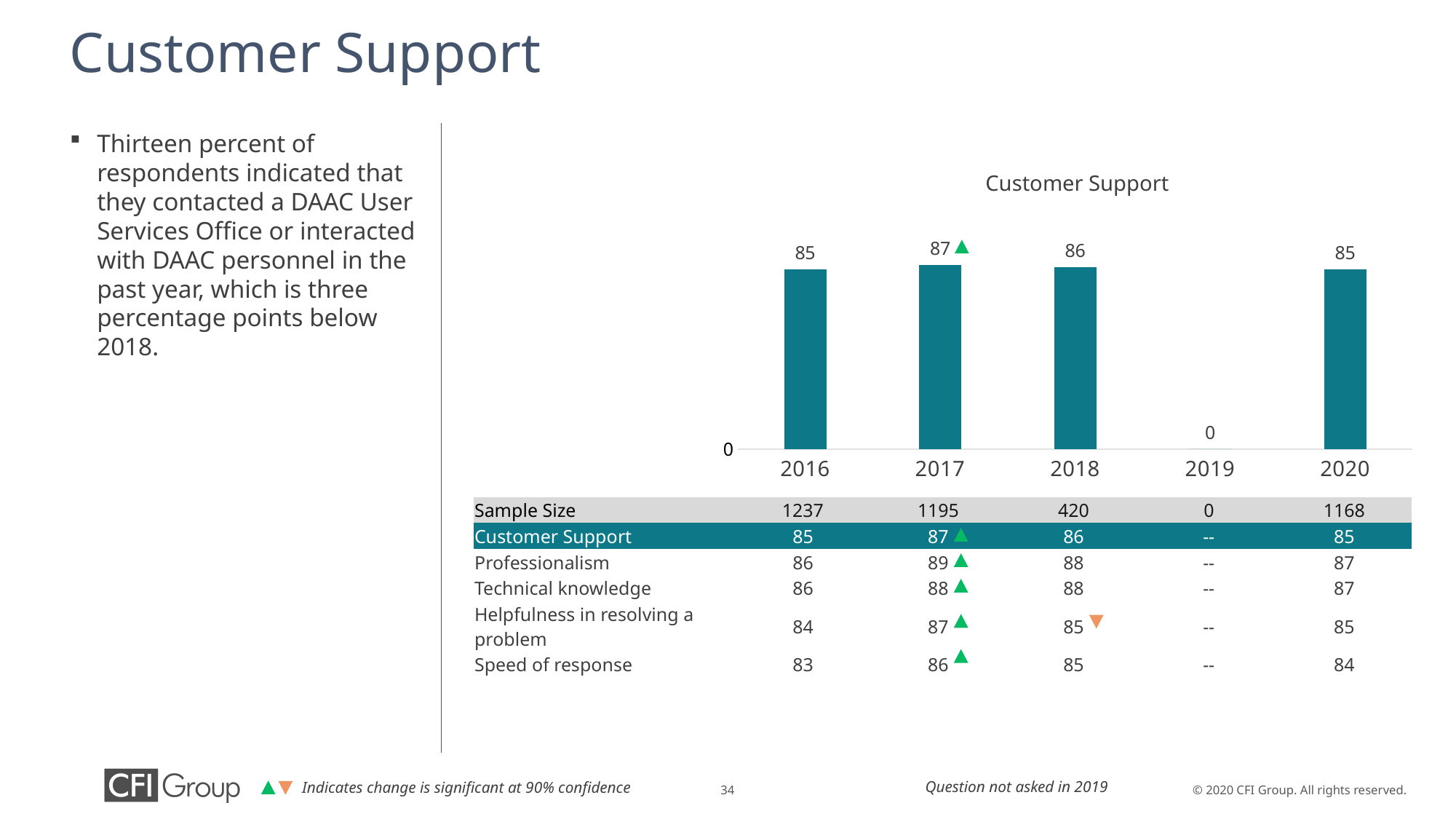
How many years are shown on the x axis of the chart? 5 Which year has the highest Customer Support value? 2017 What is the Customer Support value for 2018? 86 Which is larger, the Customer Support value for 2017 or for 2018? 2017 What is the Customer Support value for 2016? 85 What is the Customer Support value for 2017? 87 What is the title of the chart? Customer Support What is the Customer Support value for 2020? 85 What kind of chart is shown on the slide? Bar chart Does the Customer Support value rise or fall from 2017 to 2018? Fall What value is shown for 2019 in the chart? 0 What is the difference between the Customer Support values for 2017 and 2020? 2